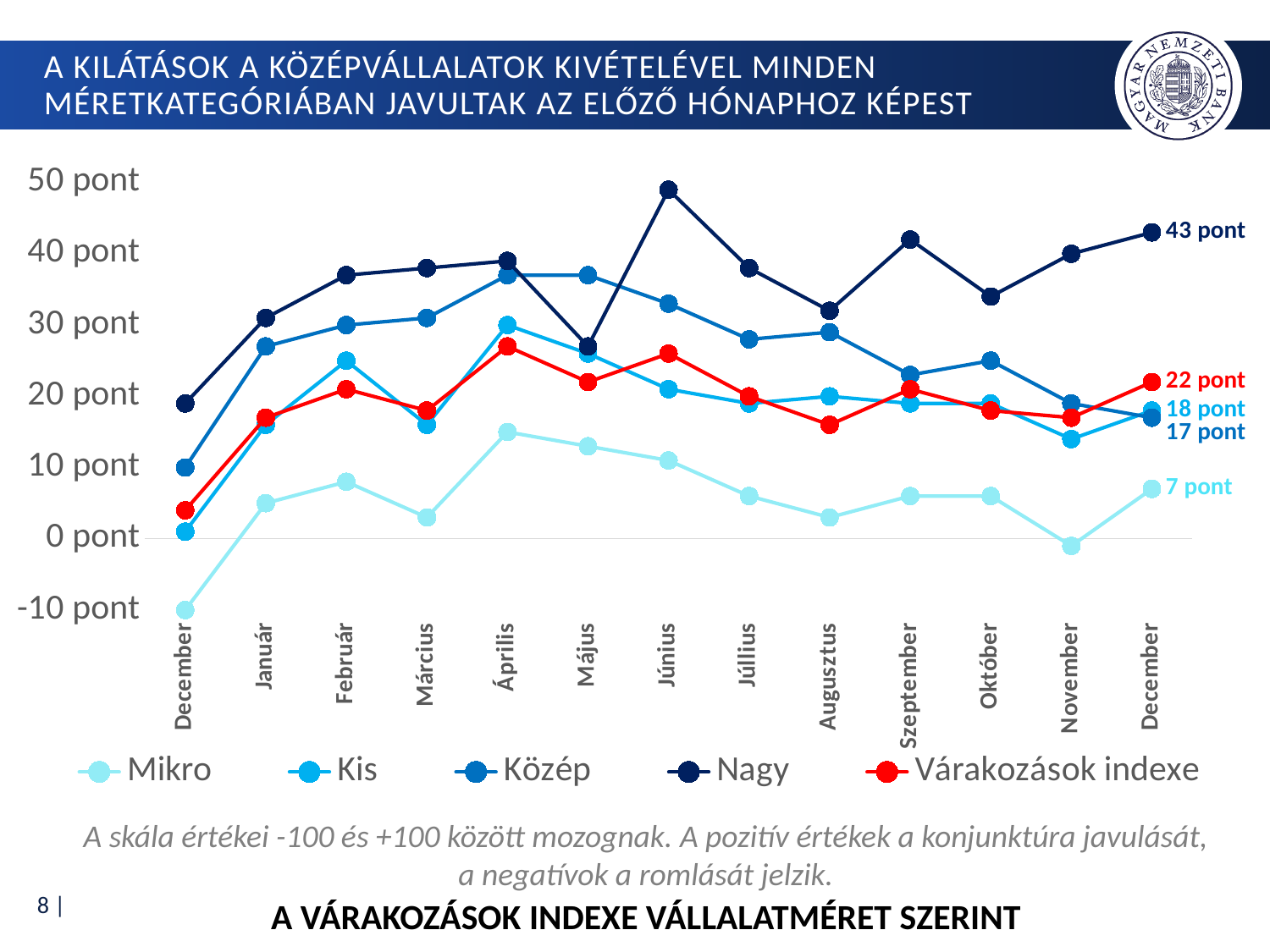
Which series has the lowest value at the final December point? Mikro What is the value of the Várakozások indexe series at the final December point? 22 pont What kind of chart is shown on the slide? Line chart What is the value of the Mikro series at the final December point? 7 pont How many series does the legend list? 5 At the final December point, which is larger: the Kis value or the Közép value? Kis Which series has the highest value at the final December point? Nagy Is the value of the Nagy series in Június greater or less than 40 pont? greater What is the value of the Nagy series at the final December point? 43 pont Does the Mikro series rise or fall from November to the final December? Rise What is the difference between the Nagy and Mikro values at the final December point? 36 pont Is the value of the Mikro series at the first December point greater or less than 0 pont? less